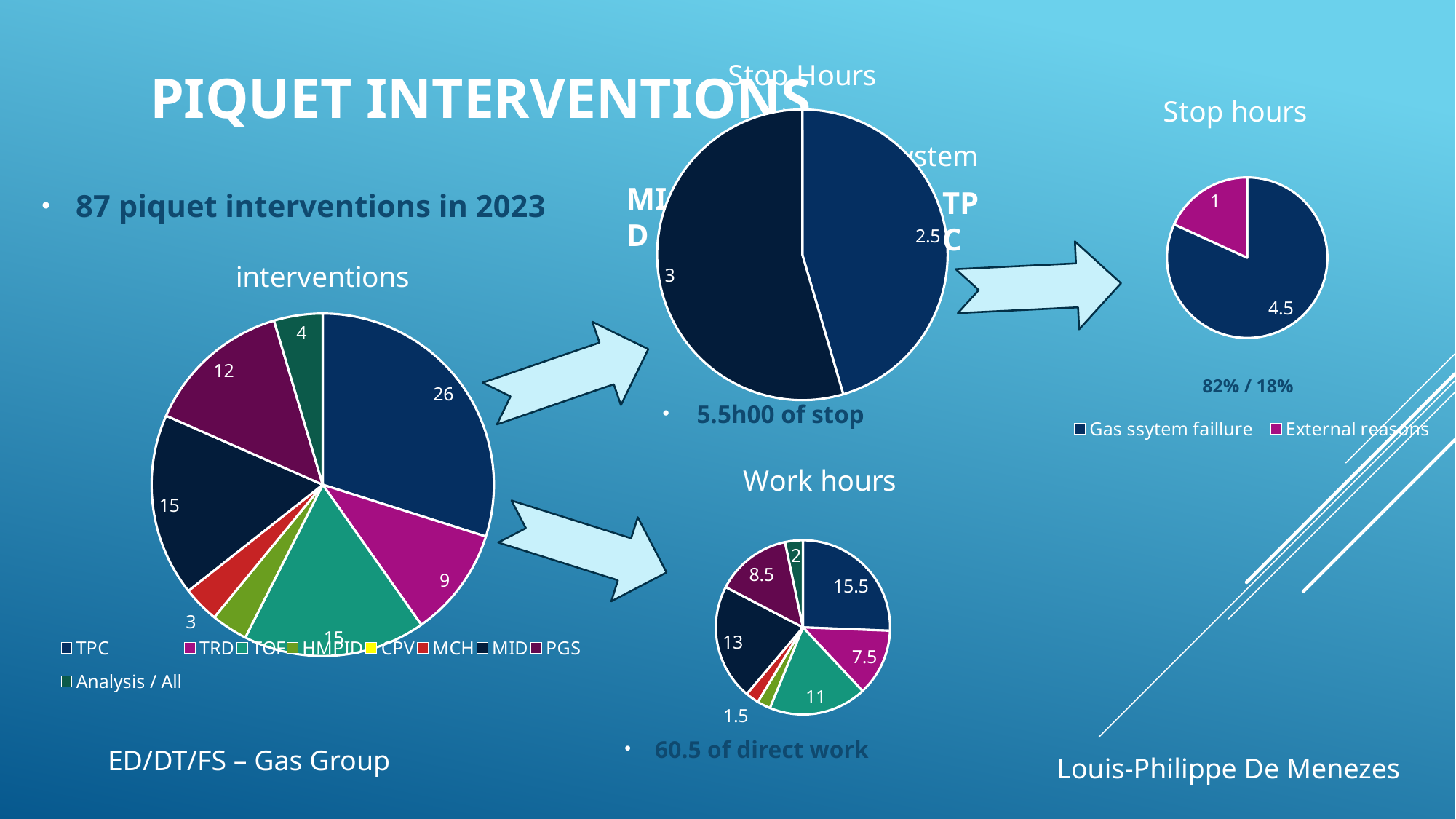
In the "interventions" pie chart, what is the value for TPC? 26 What kind of chart is the "Work hours" chart? Pie chart In the "interventions" pie chart, what is the value for PGS? 12 In the "Stop Hours" pie chart in the middle of the slide, what is the value for MID? 3 How many entries does the legend of the "interventions" pie chart list? 9 In the "interventions" pie chart, which category has the largest slice? TPC In the "Stop hours" pie chart on the right, what is the value for External reasons? 1 In the "Work hours" pie chart, what is the value shown on the largest slice? 15.5 In the "Stop hours" pie chart on the right, what share of the pie does Gas system failure represent? 82% In the "interventions" pie chart, what is the difference between the TPC value and the TRD value? 17 In the "interventions" pie chart, which is larger, the value for MID or the value for TRD? MID In the "Stop Hours" pie chart in the middle of the slide, what is the total of the two slices? 5.5